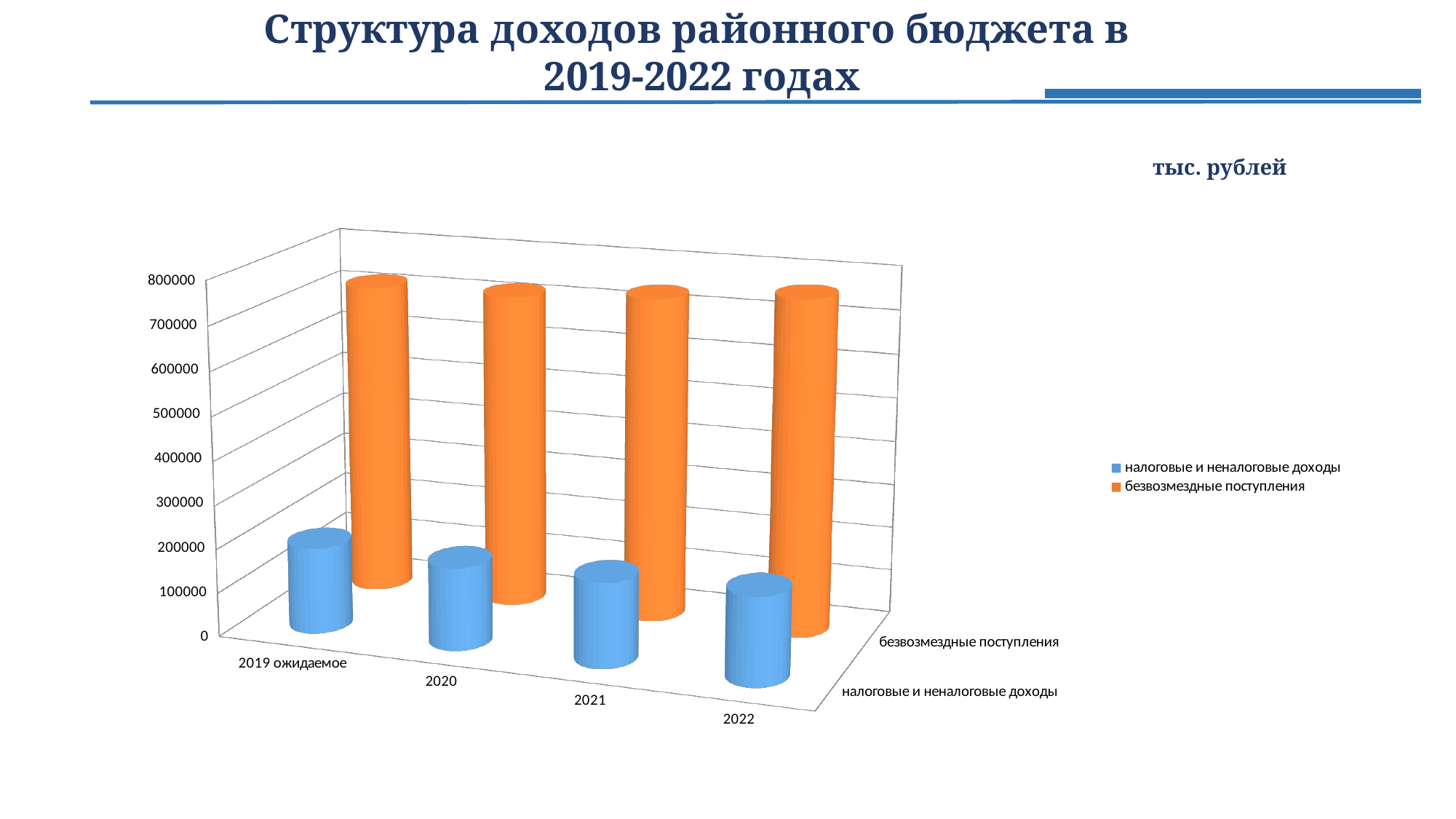
How many series does the legend list? 2 Which series is larger in 2022: налоговые и неналоговые доходы or безвозмездные поступления? безвозмездные поступления Is the value for налоговые и неналоговые доходы in 2019 ожидаемое greater or less than 500000? less Which series is larger in 2020: налоговые и неналоговые доходы or безвозмездные поступления? безвозмездные поступления What is the title of the chart on the slide? Структура доходов районного бюджета в 2019-2022 годах Is the value for безвозмездные поступления in 2019 ожидаемое greater or less than 500000? greater In what units are the values on the chart expressed, according to the slide? тыс. рублей Is the value for налоговые и неналоговые доходы in 2021 greater or less than 400000? less What kind of chart is shown on the slide? bar chart How many year categories are shown along the x axis? 4